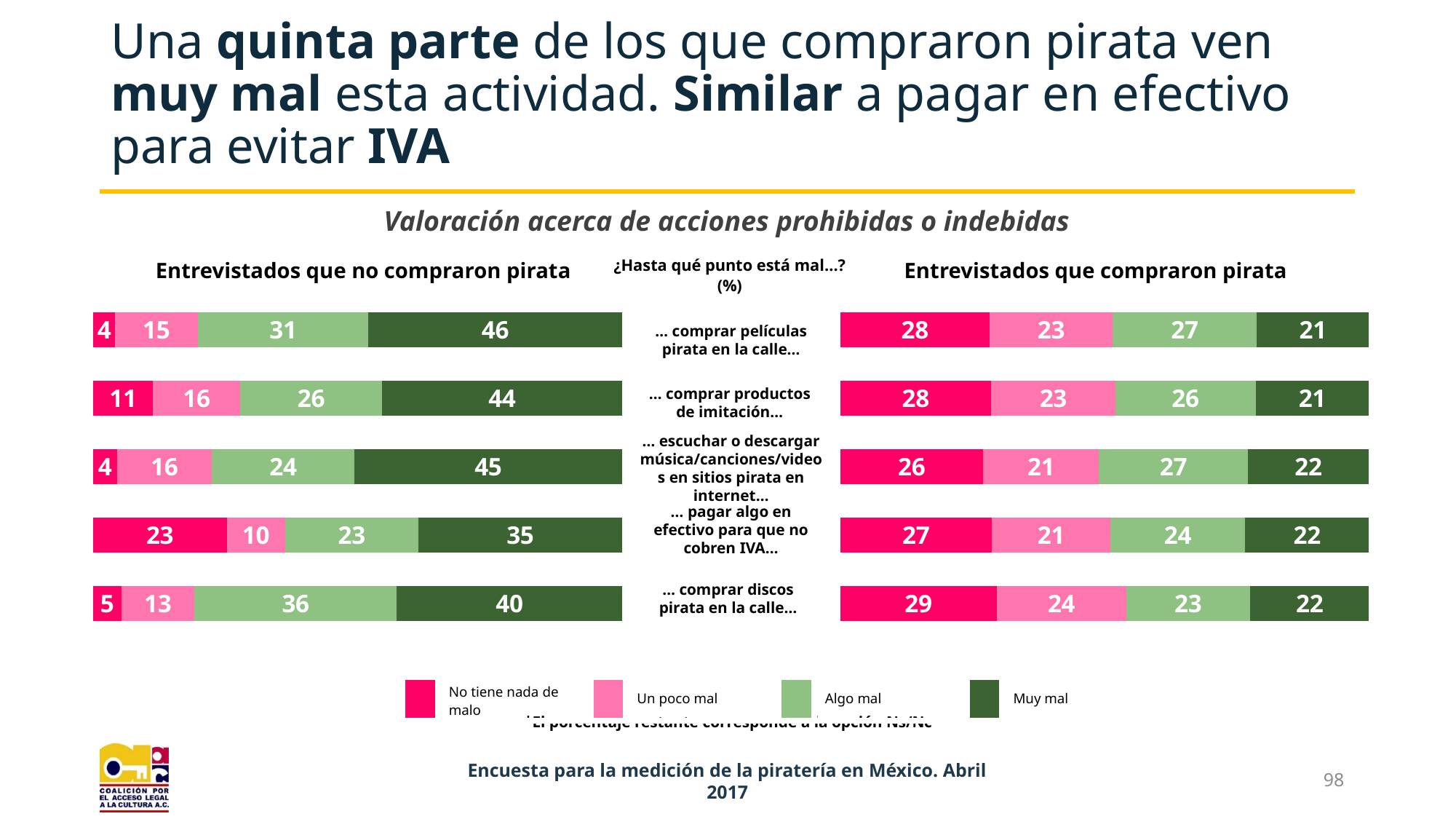
How many series does the legend list? 4 In the 'Entrevistados que compraron pirata' chart, what is the total of the bar for '... comprar productos de imitación...'? 98 In the 'Entrevistados que no compraron pirata' chart, what is the 'Muy mal' value for '... comprar películas pirata en la calle...'? 46 In the 'Entrevistados que compraron pirata' chart, what is the difference between the 'No tiene nada de malo' and 'Muy mal' values for '... comprar películas pirata en la calle...'? 7 What kind of chart is the 'Entrevistados que no compraron pirata' chart? Stacked bar chart How many categories does the 'Entrevistados que compraron pirata' chart show? 5 In the 'Entrevistados que no compraron pirata' chart, what is the 'Un poco mal' value for '... pagar algo en efectivo para que no cobren IVA...'? 10 In the 'Entrevistados que no compraron pirata' chart, which category has the lowest 'Muy mal' value? ... pagar algo en efectivo para que no cobren IVA... In the 'Entrevistados que no compraron pirata' chart, which is larger for '... comprar discos pirata en la calle...': 'Algo mal' or 'Muy mal'? Muy mal Which legend entry is shown in dark green? Muy mal In the 'Entrevistados que compraron pirata' chart, what is the 'No tiene nada de malo' value for '... comprar discos pirata en la calle...'? 29 In the 'Entrevistados que no compraron pirata' chart, which category has the highest 'No tiene nada de malo' value? ... pagar algo en efectivo para que no cobren IVA...